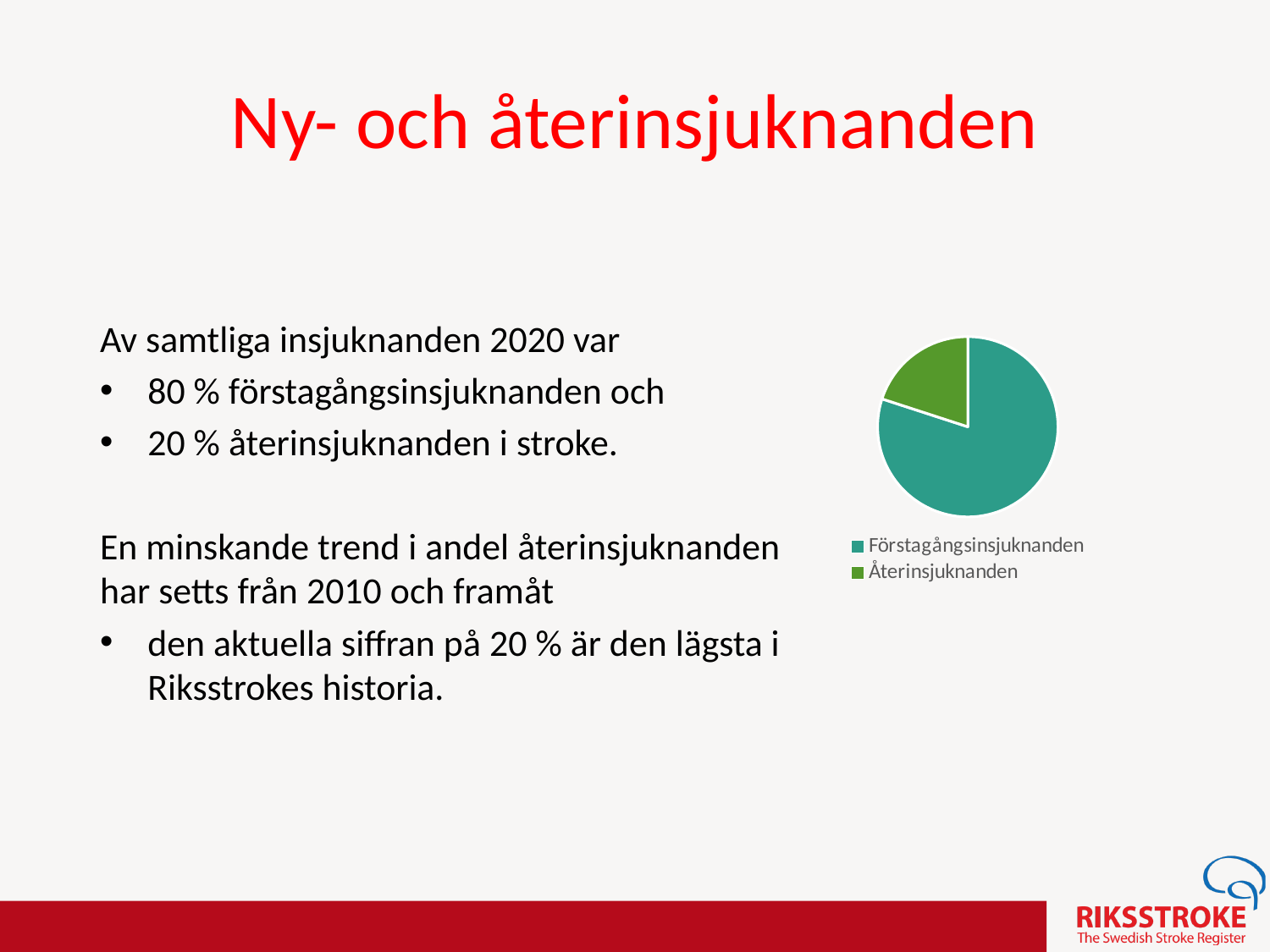
What is the first entry listed in the pie chart's legend? Förstagångsinsjuknanden Which slice of the pie chart is the smallest? Återinsjuknanden Which is larger in the pie chart, Förstagångsinsjuknanden or Återinsjuknanden? Förstagångsinsjuknanden What share of the pie does Förstagångsinsjuknanden represent? 80 % What kind of chart is shown on the slide? pie chart What colour is the Återinsjuknanden slice in the pie chart? green Which slice of the pie chart is the largest? Förstagångsinsjuknanden How many slices does the pie chart have? 2 What share of the pie does Återinsjuknanden represent? 20 % How many entries does the legend of the pie chart list? 2